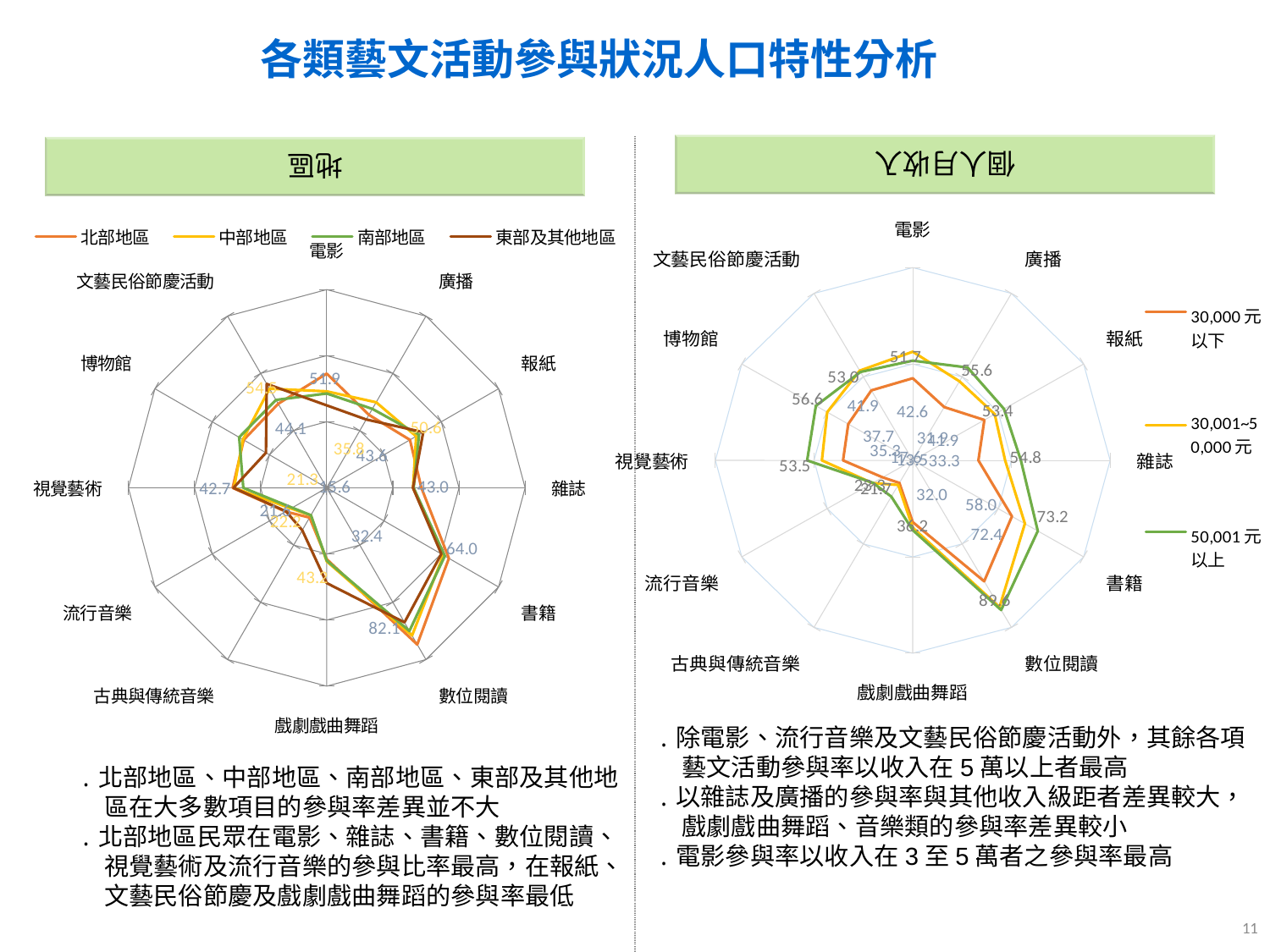
In the left chart (地區), which activity category has the highest participation values across the regions? 數位閱讀 In the right chart (個人收入), which activity category has the highest participation values for all income groups? 數位閱讀 How many series does the legend of the left chart (地區) list? 4 How many activity categories are plotted around the right chart (個人收入)? 12 How many activity categories are plotted around the left chart (地區)? 12 How many series does the legend of the right chart (個人收入) list? 3 What kind of chart is shown on the left side of the slide under the heading 地區? Radar chart What are the three income groups listed in the legend of the right chart? 30,000元以下, 30,001~50,000元, 50,001元以上 In the right chart (個人收入), is the value for 書籍 larger or smaller than the value for 雜誌 for the 50,001元以上 group? Larger In the left chart (地區), is the value for 數位閱讀 larger or smaller than the value for 電影 for 北部地區? Larger What kind of chart is shown on the right side of the slide under the heading 個人收入? Radar chart Which series in the left chart (地區) is drawn in dark brown? 東部及其他地區